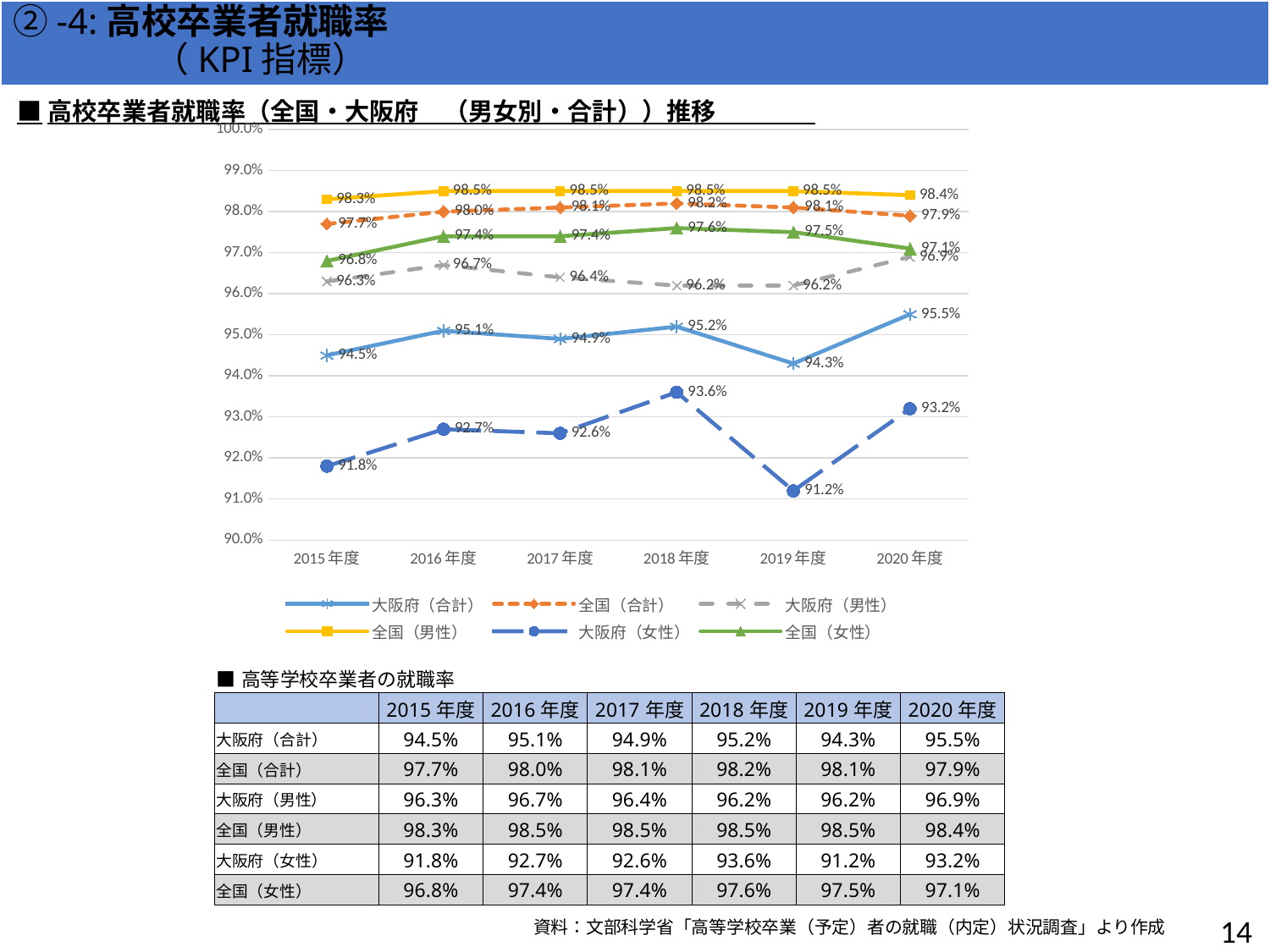
What is the value for 大阪府（女性） in 2019年度? 91.2% In which year is the value for 大阪府（女性） lowest? 2019年度 What kind of chart is shown on the slide? line chart What is the value for 全国（合計） in 2018年度? 98.2% How many years are shown on the x axis of the chart? 6 Does the value for 全国（合計） rise or fall from 2015年度 to 2018年度? rise Is the value for 大阪府（合計） in 2019年度 greater or less than 95.0%? less In which year is the value for 大阪府（合計） highest? 2020年度 How many series does the chart's legend list? 6 In 2020年度, which is larger: 大阪府（男性） or 全国（女性）? 全国（女性） By how much did 大阪府（女性） fall from 2018年度 to 2019年度? 2.4 percentage points What is the difference between 全国（男性） and 大阪府（女性） in 2015年度? 6.5 percentage points